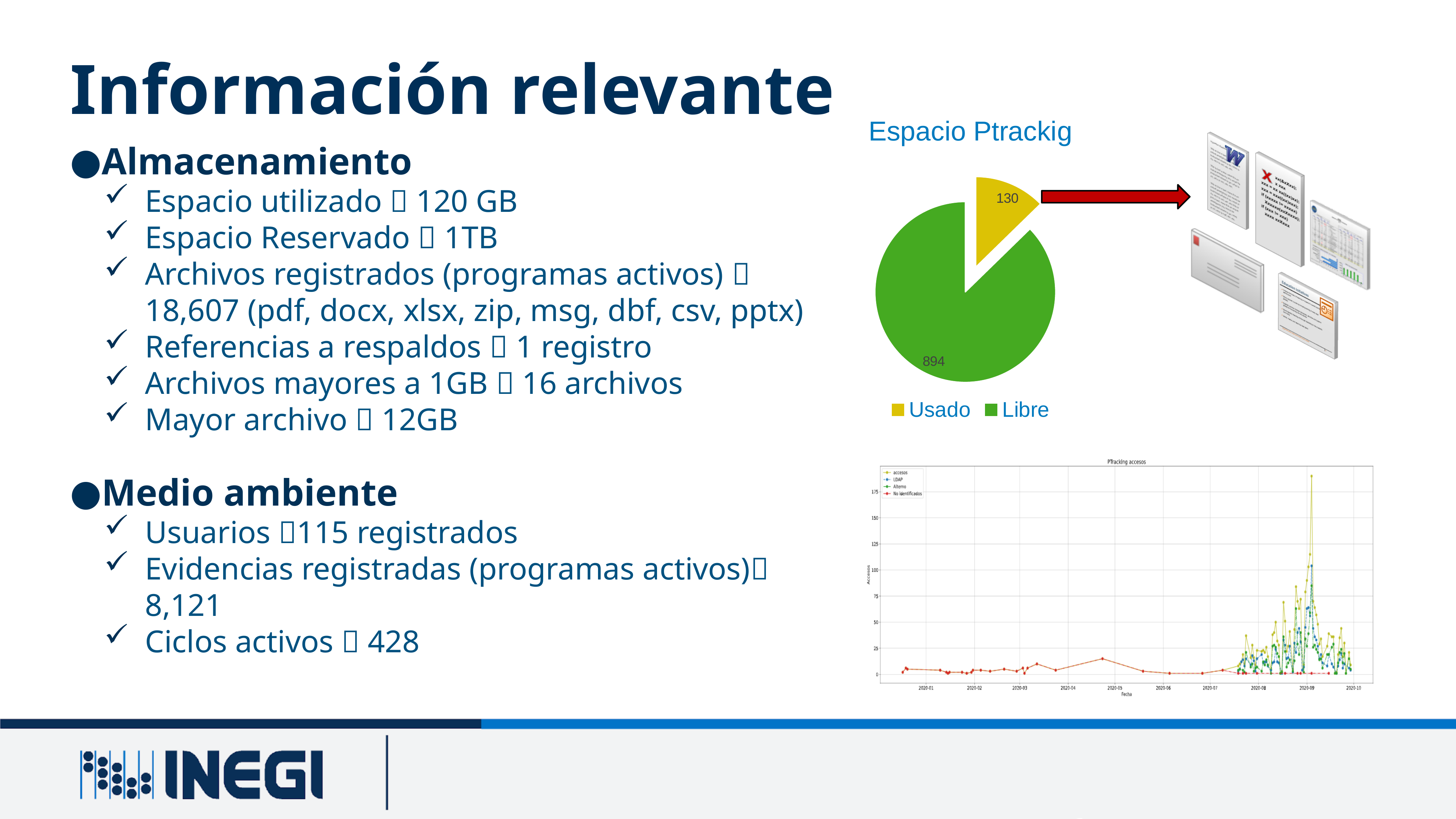
How many slices does the 'Espacio Ptrackig' pie chart have? 2 In the 'Espacio Ptrackig' pie chart, which slice is the smallest? Usado In the 'Espacio Ptrackig' pie chart, what is the difference between Libre and Usado? 764 In the 'Espacio Ptrackig' pie chart, what is the total of the two slices? 1024 What type of chart is 'PTracking accesos' at the bottom right of the slide? line chart What type of chart is 'Espacio Ptrackig'? pie chart In the 'Espacio Ptrackig' pie chart, is Usado larger or smaller than Libre? smaller In the 'Espacio Ptrackig' pie chart, which slice is the largest? Libre In the 'Espacio Ptrackig' pie chart, what is the value for Libre? 894 In the 'Espacio Ptrackig' pie chart, what share of the total does Usado represent? 12.7% In the 'Espacio Ptrackig' pie chart, what colour is the Libre slice? green In the 'Espacio Ptrackig' pie chart, what is the value for Usado? 130